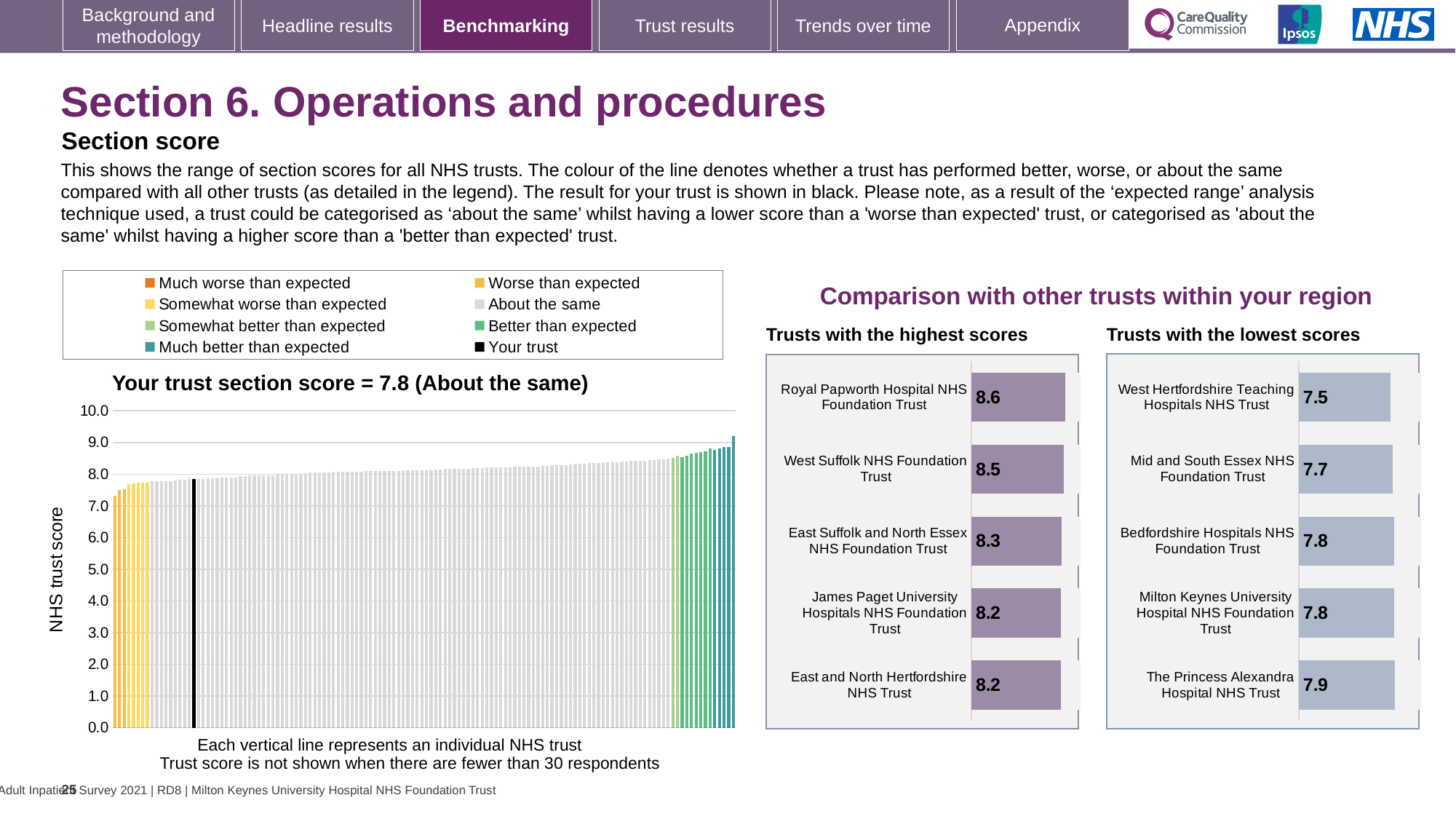
How many trusts are shown in the 'Trusts with the highest scores' chart? 5 In the 'Trusts with the highest scores' chart, what is the score for Royal Papworth Hospital NHS Foundation Trust? 8.6 In the 'Trusts with the lowest scores' chart, which trust has the lowest score? West Hertfordshire Teaching Hospitals NHS Trust In the 'Trusts with the lowest scores' chart, what is the score for Milton Keynes University Hospital NHS Foundation Trust? 7.8 In the main chart on the left, what is your trust's section score? 7.8 In the 'Trusts with the lowest scores' chart, what is the score for West Hertfordshire Teaching Hospitals NHS Trust? 7.5 In the 'Trusts with the lowest scores' chart, which has the larger score: Mid and South Essex NHS Foundation Trust or The Princess Alexandra Hospital NHS Trust? The Princess Alexandra Hospital NHS Trust How many entries does the legend above the main chart on the left list? 8 In the main chart on the left, is the value for your trust (the black bar) greater or less than 5.0? greater What kind of chart is the 'Trusts with the highest scores' chart? bar chart In the 'Trusts with the highest scores' chart, what is the difference between the scores of Royal Papworth Hospital NHS Foundation Trust and East Suffolk and North Essex NHS Foundation Trust? 0.3 In the 'Trusts with the highest scores' chart, which trust has the highest score? Royal Papworth Hospital NHS Foundation Trust